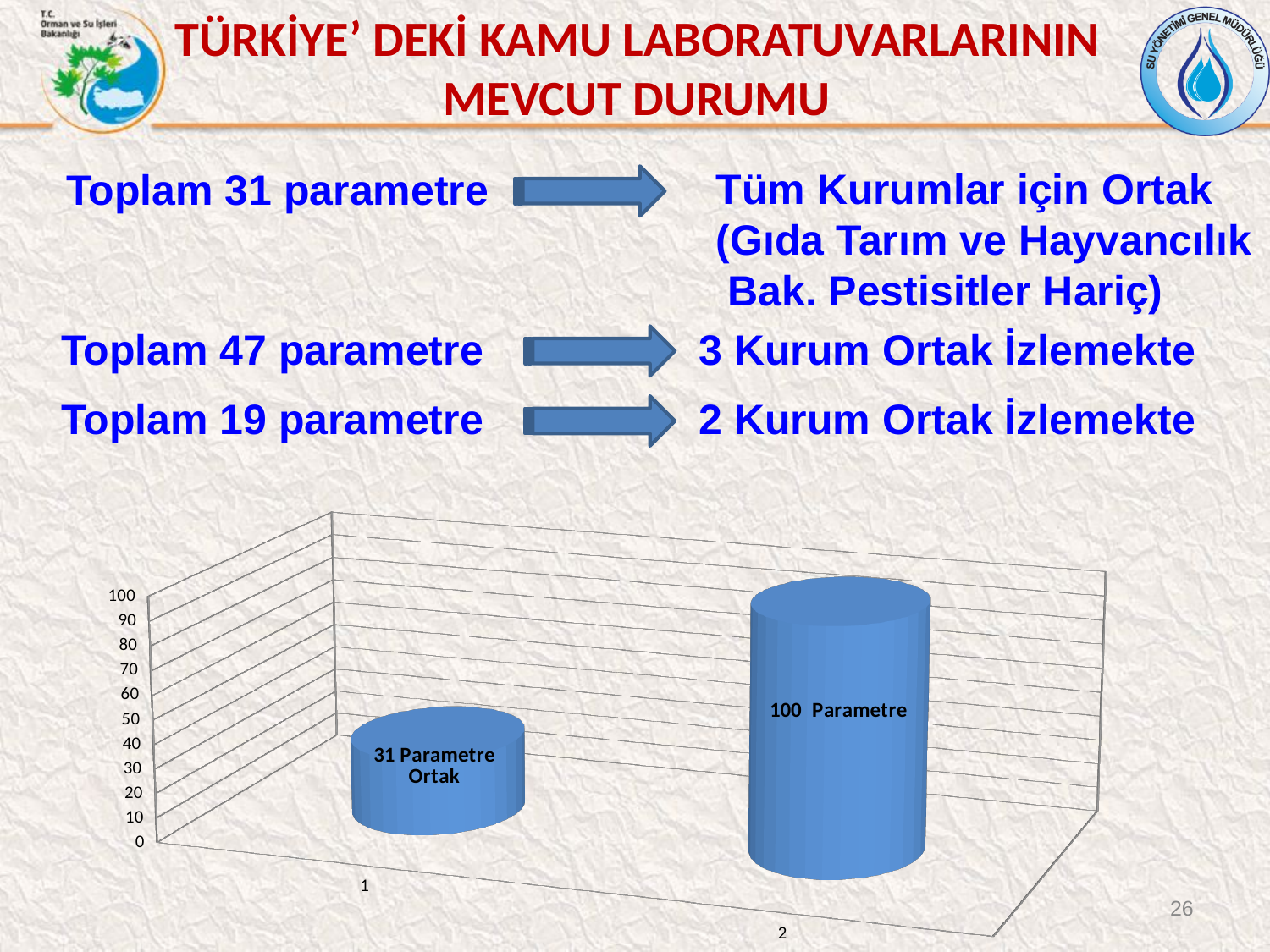
What is the difference between the values for category 2 and category 1? 69 Is the value for category 1 greater or less than 50? less What kind of chart is shown on the slide? bar chart Which category has the lowest bar? 1 What is the highest tick value shown on the vertical axis? 100 What value does the bar for category 2 represent? 100 What is the data label on the bar for category 1? 31 Parametre Ortak Which category has the highest bar? 2 How many bars does the chart show? 2 What value does the bar for category 1 represent? 31 What is the data label on the bar for category 2? 100 Parametre Which is larger, the value for category 1 or the value for category 2? category 2